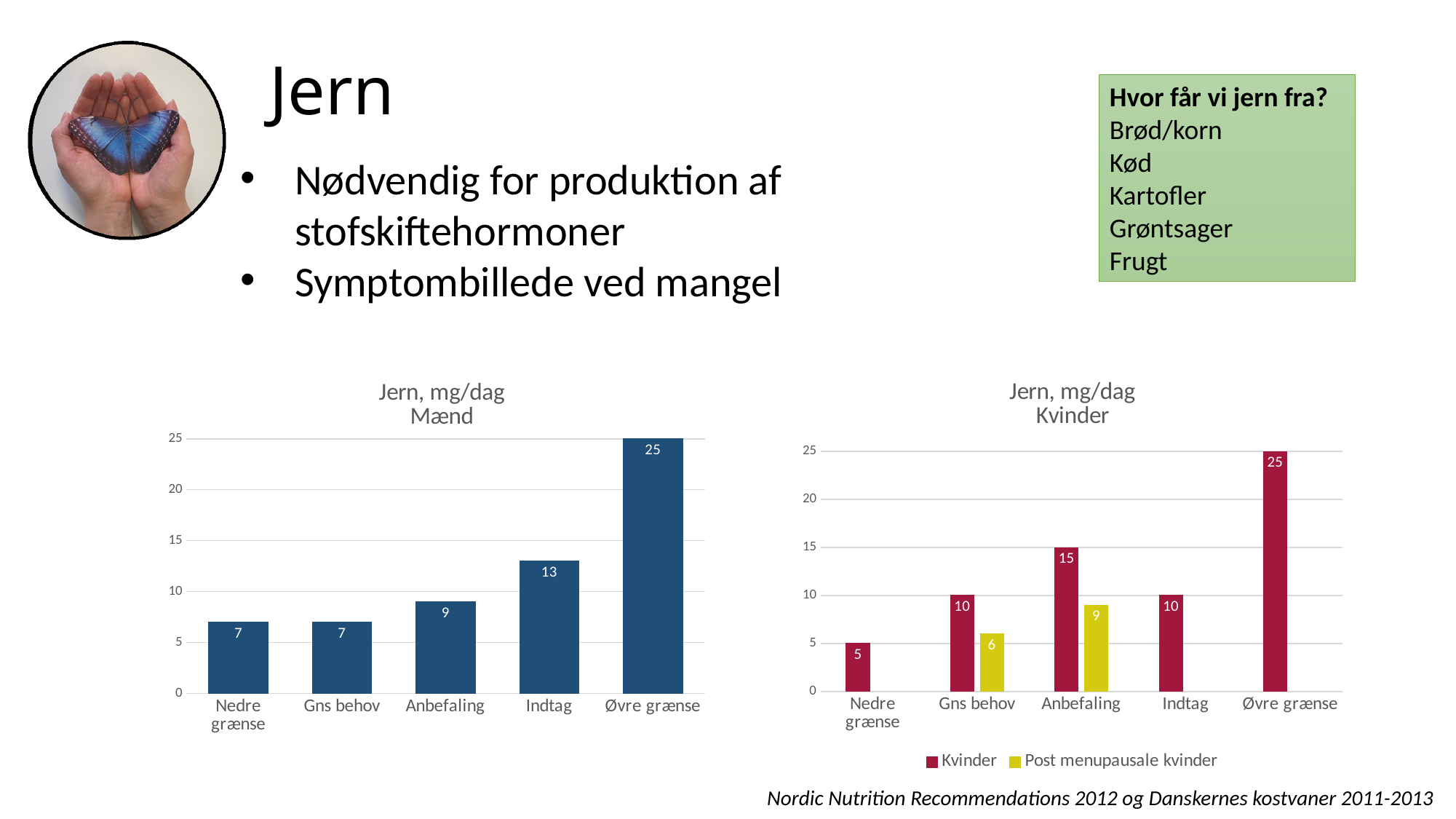
In the 'Jern, mg/dag Mænd' chart, what is the difference between Øvre grænse and Indtag? 12 In the 'Jern, mg/dag Mænd' chart, which category has the highest value? Øvre grænse In the 'Jern, mg/dag Kvinder' chart, what is the Kvinder value for Anbefaling? 15 In the 'Jern, mg/dag Mænd' chart, how many categories are shown on the x axis? 5 In the 'Jern, mg/dag Mænd' chart, what is the value for Indtag? 13 In the 'Jern, mg/dag Kvinder' chart, which category has the lowest Kvinder value? Nedre grænse In the 'Jern, mg/dag Kvinder' chart, which is larger for Anbefaling: Kvinder or Post menupausale kvinder? Kvinder In the 'Jern, mg/dag Kvinder' chart, what is the Post menupausale kvinder value for Gns behov? 6 In the 'Jern, mg/dag Mænd' chart, what is the value for Anbefaling? 9 In the 'Jern, mg/dag Kvinder' chart, what is the difference between the Kvinder and Post menupausale kvinder values for Anbefaling? 6 How many series does the legend of the 'Jern, mg/dag Kvinder' chart list? 2 What kind of chart is the 'Jern, mg/dag Mænd' chart? Bar chart